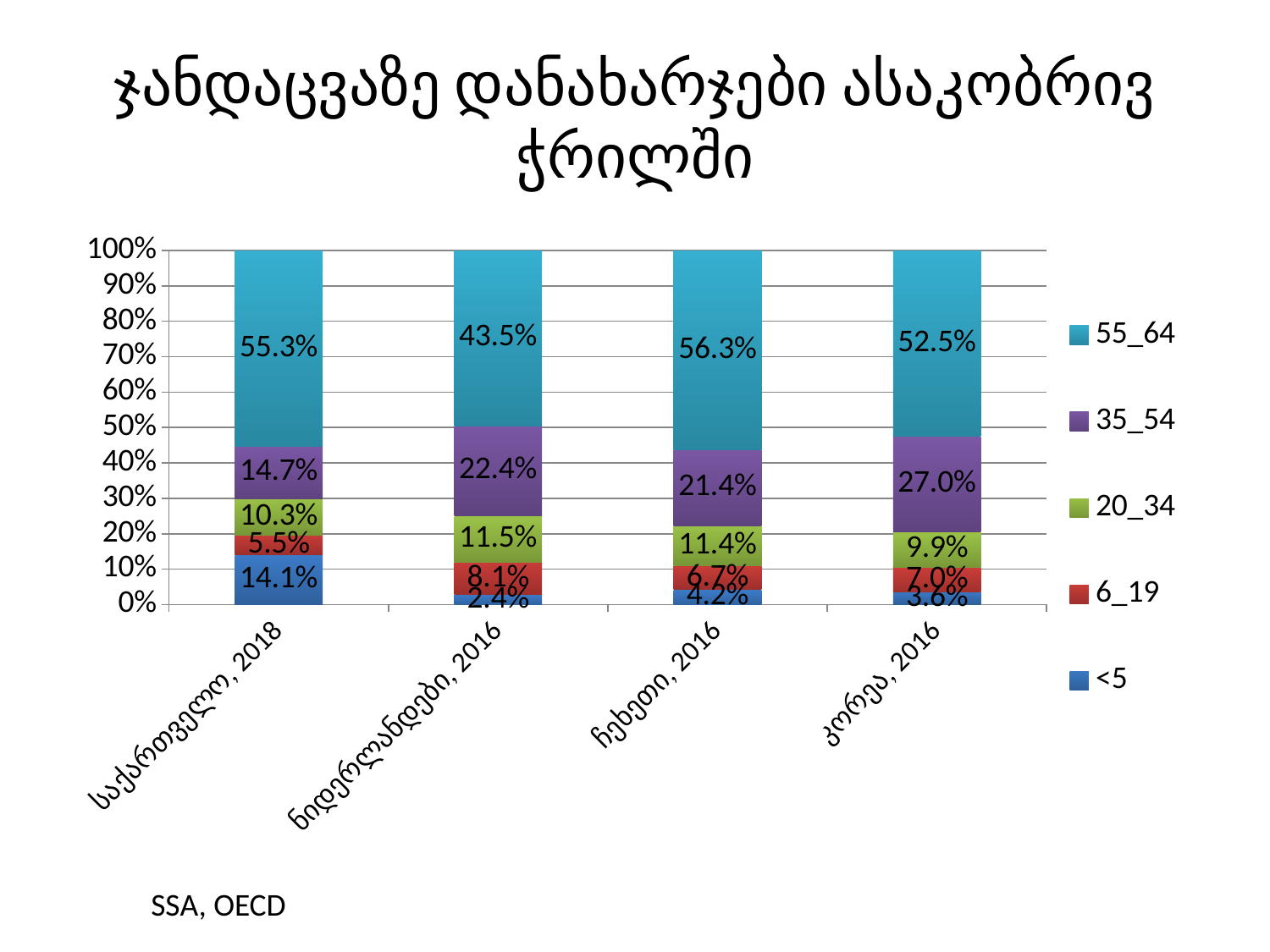
Which category has the lowest value for the 35_54 series? საქართველო, 2018 Which category has the highest value for the 55_64 series? ჩეხეთი, 2016 What kind of chart is shown on the slide? Stacked bar chart How many categories are shown on the x axis? 4 Which is larger: the 55_64 value for ნიდერლანდები, 2016 or for კორეა, 2016? კორეა, 2016 What is the value of the 20_34 series for ნიდერლანდები, 2016? 11.5% What is the value of the <5 series for საქართველო, 2018? 14.1% What is the value of the 6_19 series for ჩეხეთი, 2016? 6.7% What is the value of the 55_64 series for საქართველო, 2018? 55.3% How many series does the legend list? 5 What is the value of the 35_54 series for კორეა, 2016? 27.0% What is the difference between the 35_54 values for კორეა, 2016 and ნიდერლანდები, 2016? 4.6%